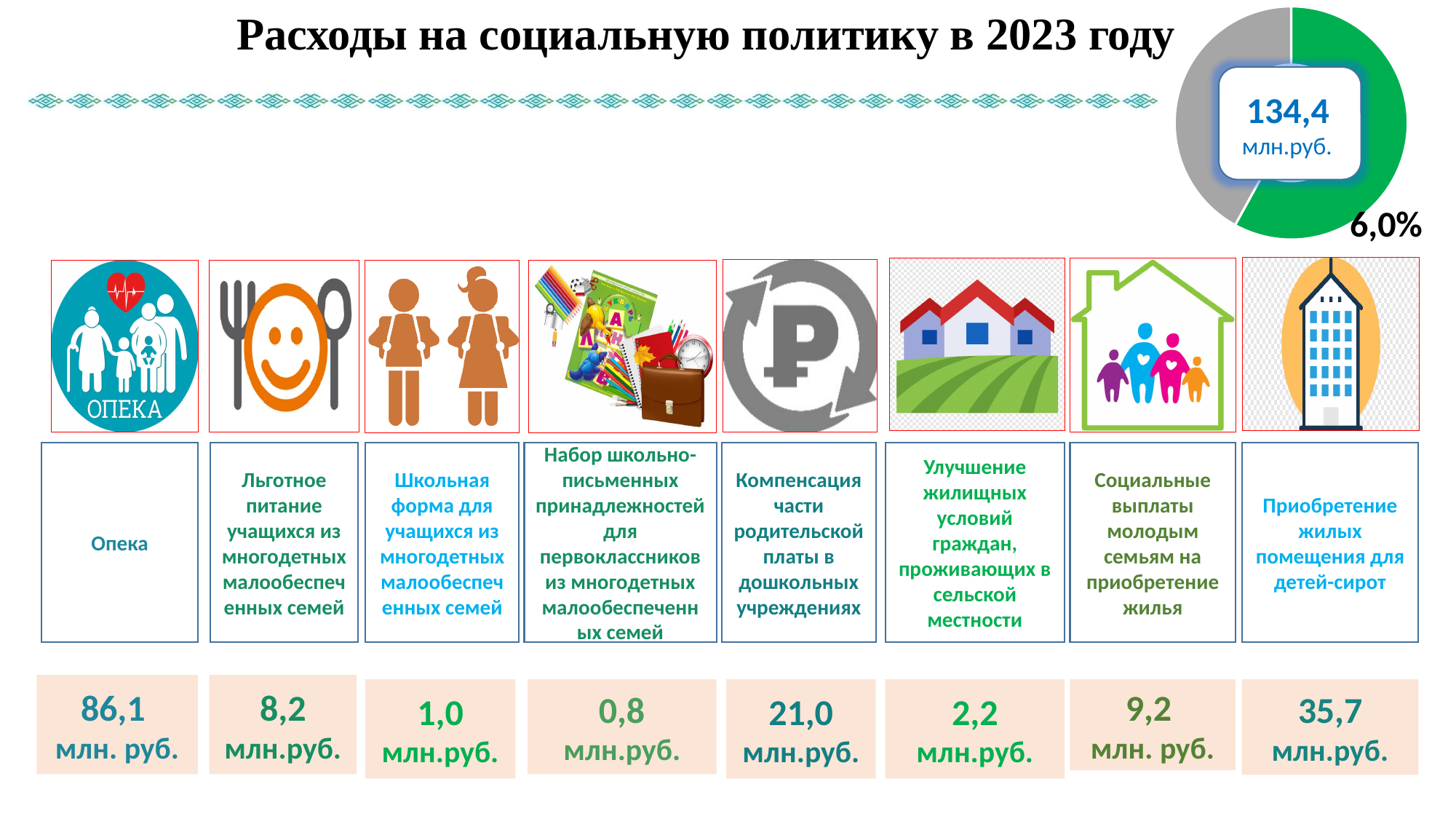
What value is printed in the centre of the pie chart? 134,4 млн.руб. What two colours are used for the slices of the pie chart? green and grey Which slice of the pie chart is larger, the green one or the grey one? green What kind of chart is shown in the top right corner of the slide? doughnut chart How many slices does the pie chart in the top right have? 2 What is the title of the slide containing the pie chart? Расходы на социальную политику в 2023 году What percentage label is printed next to the green slice of the pie chart? 6,0%